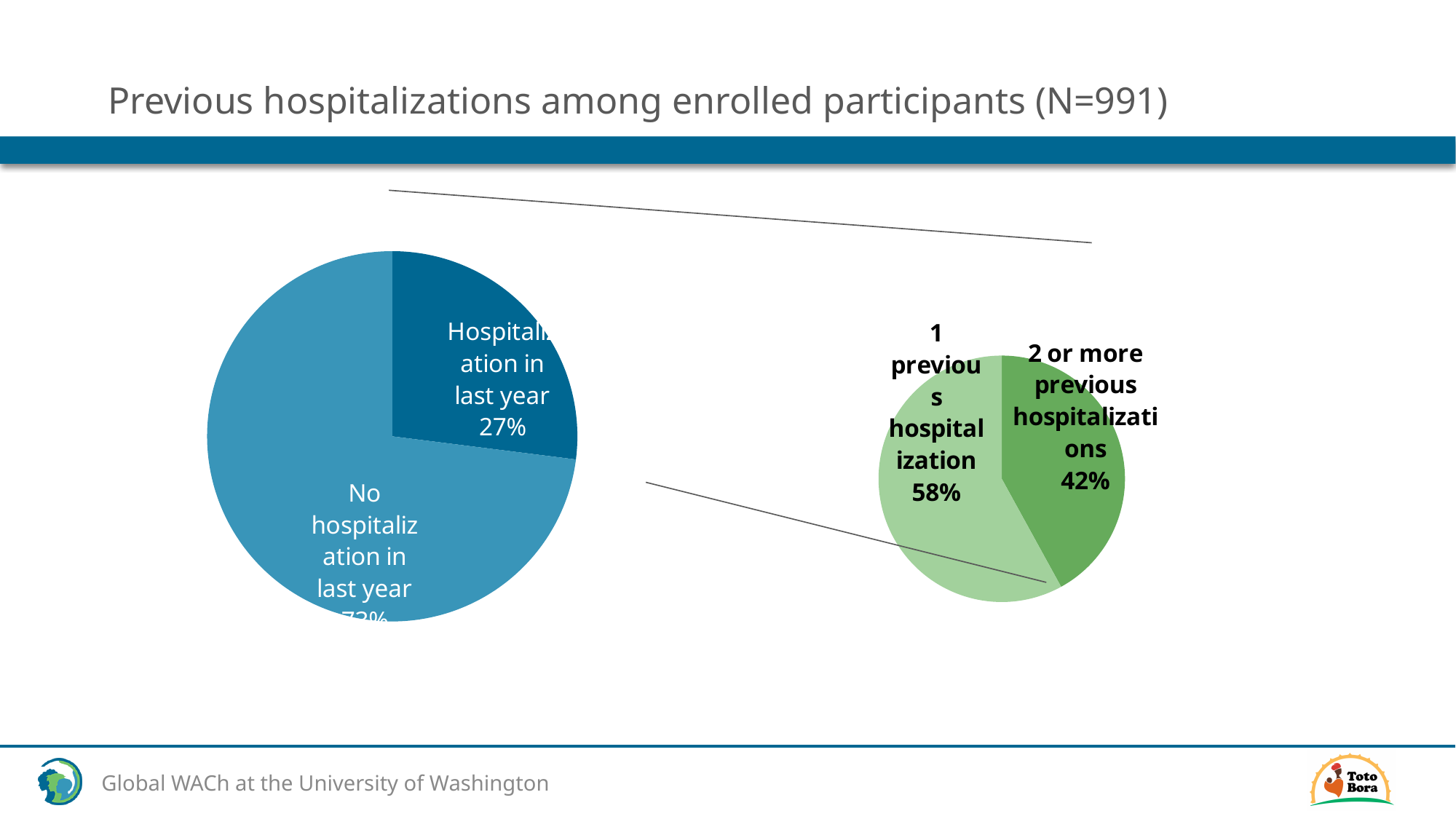
In the right pie chart, which slice is the smallest? 2 or more previous hospitalizations How many slices does the right pie chart have? 2 What kind of chart is shown on the left of the slide? Pie chart In the right pie chart, what share had 1 previous hospitalization? 58% How many slices does the left pie chart have? 2 In the left pie chart, what share of participants had a hospitalization in the last year? 27% In the left pie chart, which slice is larger: hospitalization in last year or no hospitalization in last year? No hospitalization in last year In the right pie chart, which slice is larger: 1 previous hospitalization or 2 or more previous hospitalizations? 1 previous hospitalization What is the title of the slide? Previous hospitalizations among enrolled participants (N=991) In the right pie chart, what share had 2 or more previous hospitalizations? 42% What kind of chart is shown on the right of the slide? Pie chart In the right pie chart, what is the difference in percentage points between the 1 previous hospitalization slice and the 2 or more previous hospitalizations slice? 16 percentage points